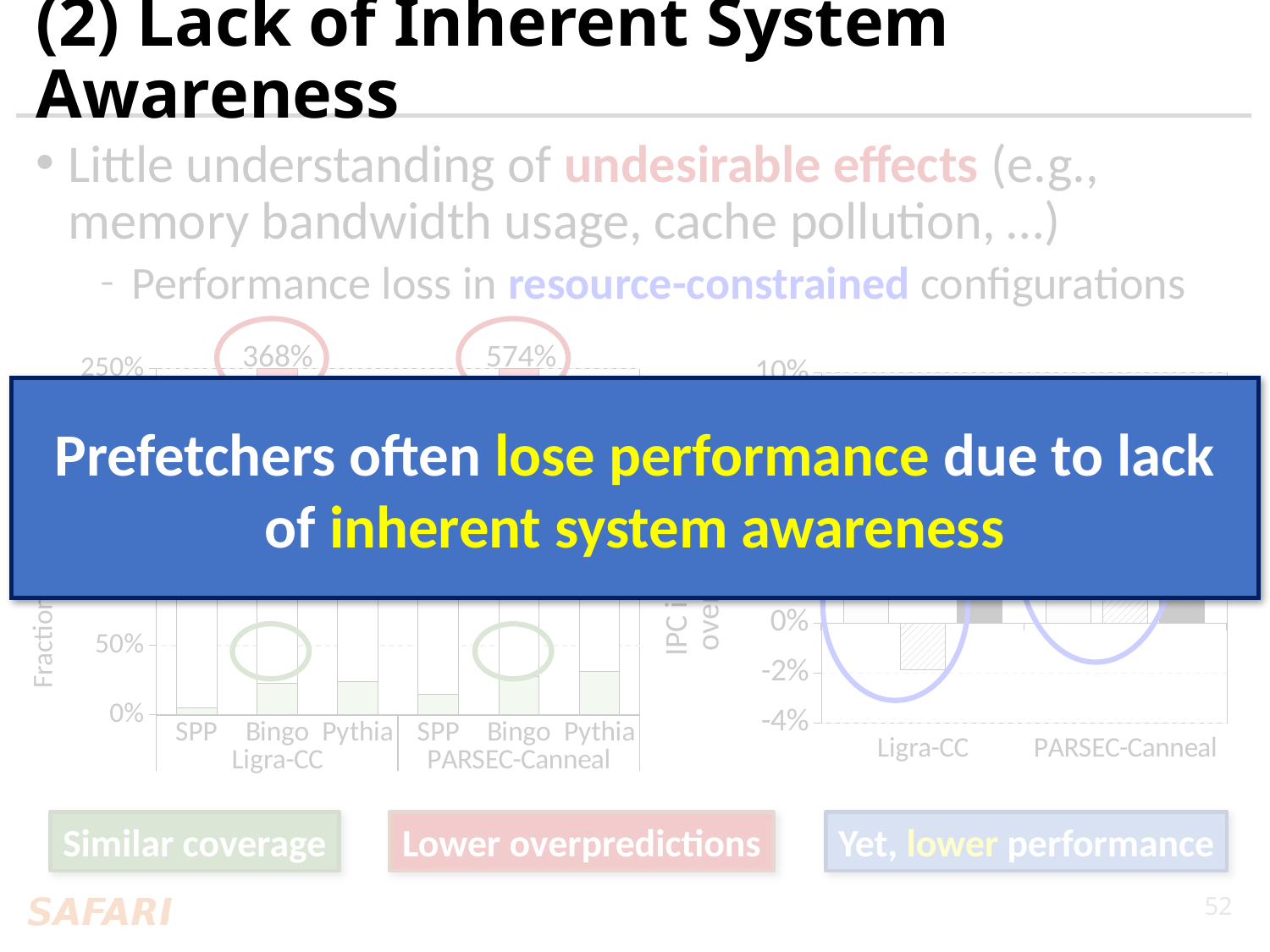
In the left chart, which two workloads are shown on the x axis? Ligra-CC and PARSEC-Canneal In the right chart, is the hatched bar for Ligra-CC greater or less than 0%? less In the left chart, which three prefetchers are listed on the x axis for each workload? SPP, Bingo, Pythia In the right chart, what is the lowest value shown on the y axis? -4% In the left chart, how many prefetcher bars are shown in total across both workloads? 6 In the right chart, how many workload categories are shown on the x axis? 2 In the left chart, what value is printed in the circle above the Bingo bar for Ligra-CC? 368% What kind of chart is the right chart on the slide? bar chart What kind of chart is the left chart on the slide? bar chart In the left chart, which of the two circled values is larger, the one for Ligra-CC or the one for PARSEC-Canneal? PARSEC-Canneal In the left chart, what value is printed in the circle above the Bingo bar for PARSEC-Canneal? 574% In the left chart, what is the difference between the two circled values, 574% and 368%? 206%